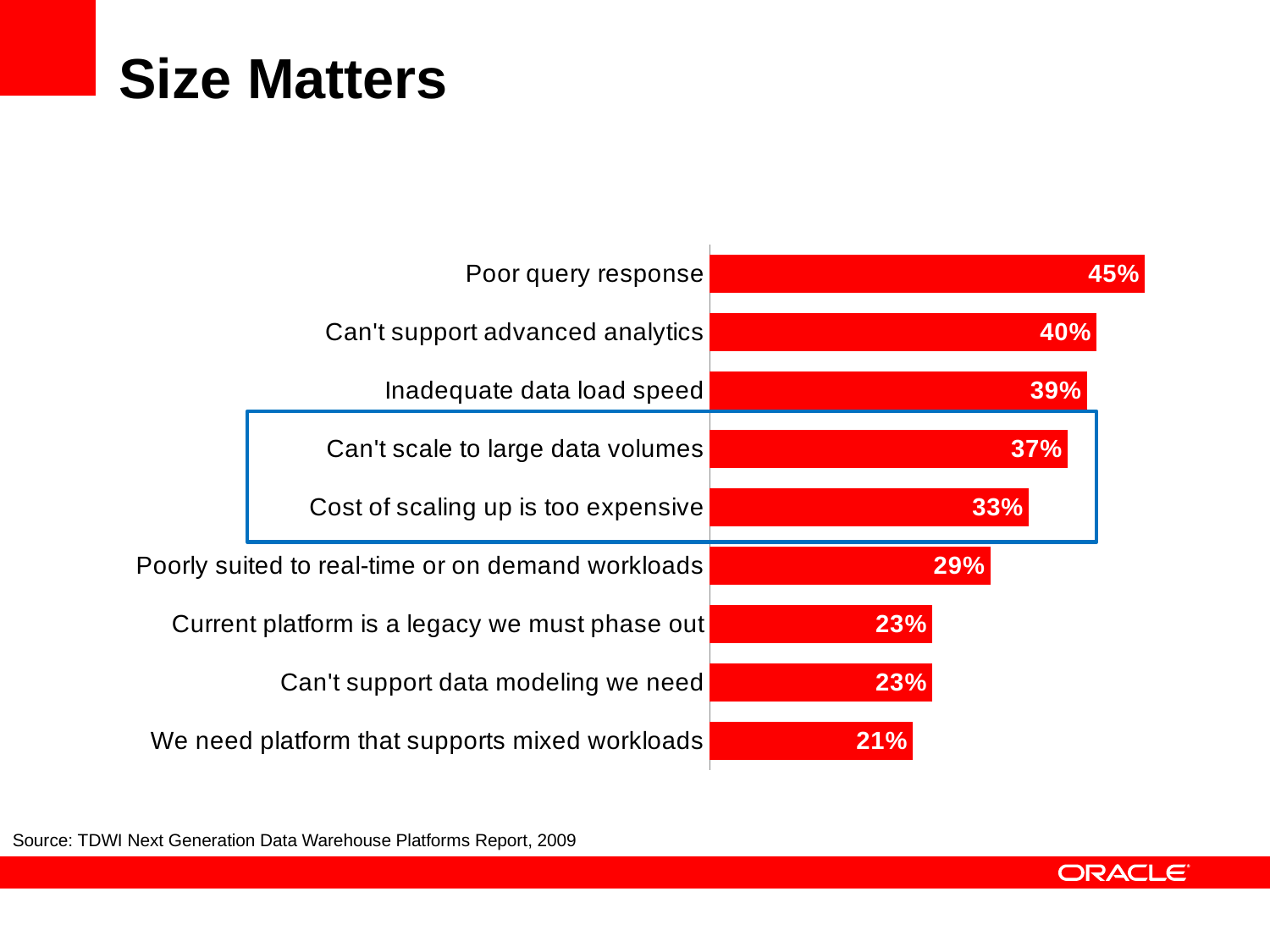
What is the value for "Poor query response"? 45% What is the value for "Poorly suited to real-time or on demand workloads"? 29% What is the value for "Cost of scaling up is too expensive"? 33% What is the difference between "Can't scale to large data volumes" and "Cost of scaling up is too expensive"? 4% How many categories are shown in the chart? 9 Which two categories are enclosed by the blue highlight box? Can't scale to large data volumes; Cost of scaling up is too expensive Which category has the highest value? Poor query response What is the value for "Can't scale to large data volumes"? 37% What kind of chart is shown on the slide? Bar chart Which is larger, "Inadequate data load speed" or "Poorly suited to real-time or on demand workloads"? Inadequate data load speed What is the difference between "Poor query response" and "Can't support advanced analytics"? 5% Which category has the lowest value? We need platform that supports mixed workloads